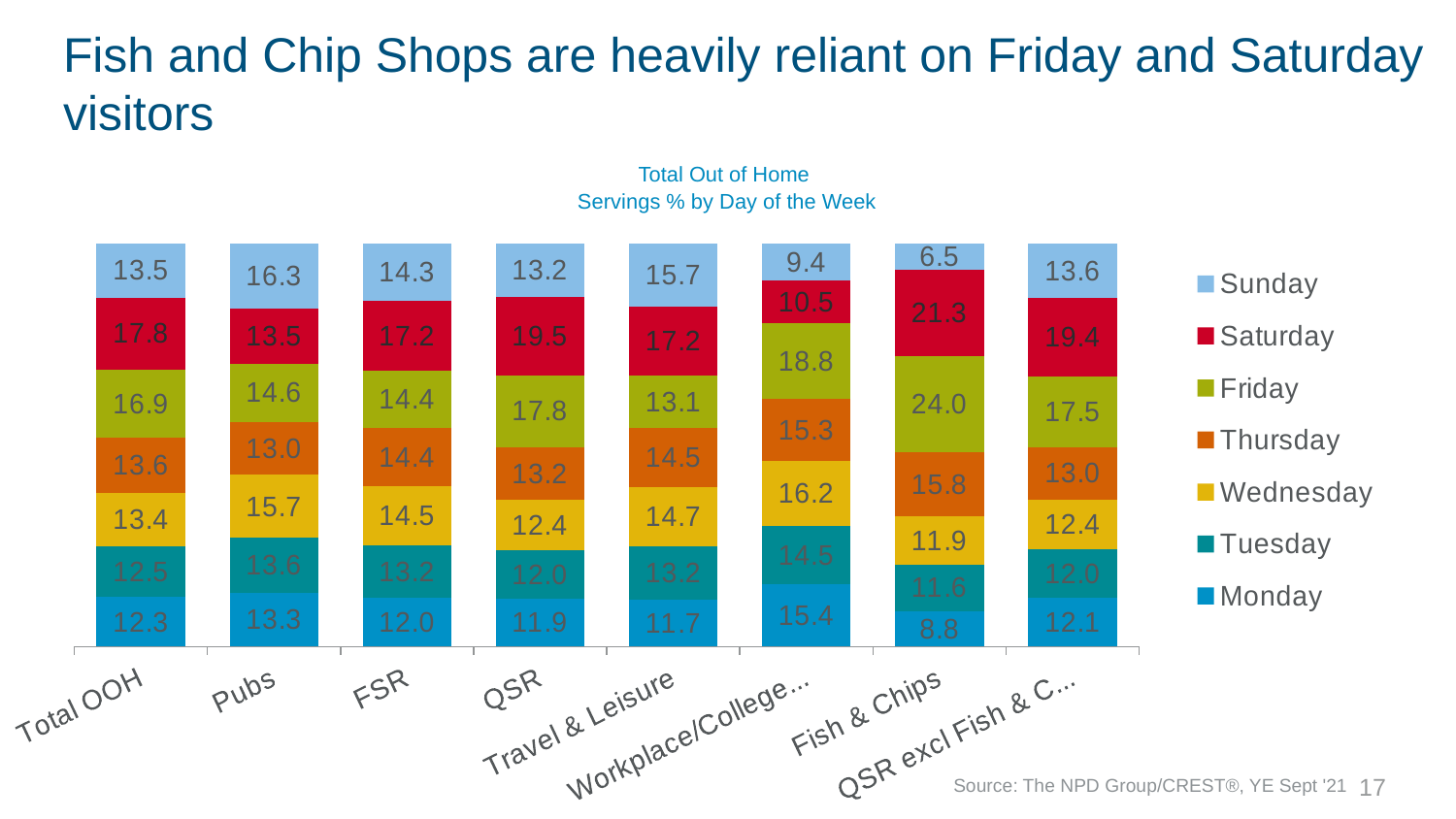
What is the Wednesday value for Travel & Leisure? 14.7 Which category has the highest Friday value? Fish & Chips How many series does the legend list? 7 Which category has the lowest Sunday value? Fish & Chips How many categories are shown on the x axis? 8 Which is larger, the Saturday value for QSR or the Saturday value for FSR? QSR What is the Monday value for Total OOH? 12.3 What is the difference between the Saturday value for Fish & Chips and the Saturday value for Total OOH? 3.5 What is the difference between the Friday and Sunday values for Fish & Chips? 17.5 What type of chart is shown? Stacked bar chart What is the Sunday value for Pubs? 16.3 What is the Friday value for Fish & Chips? 24.0